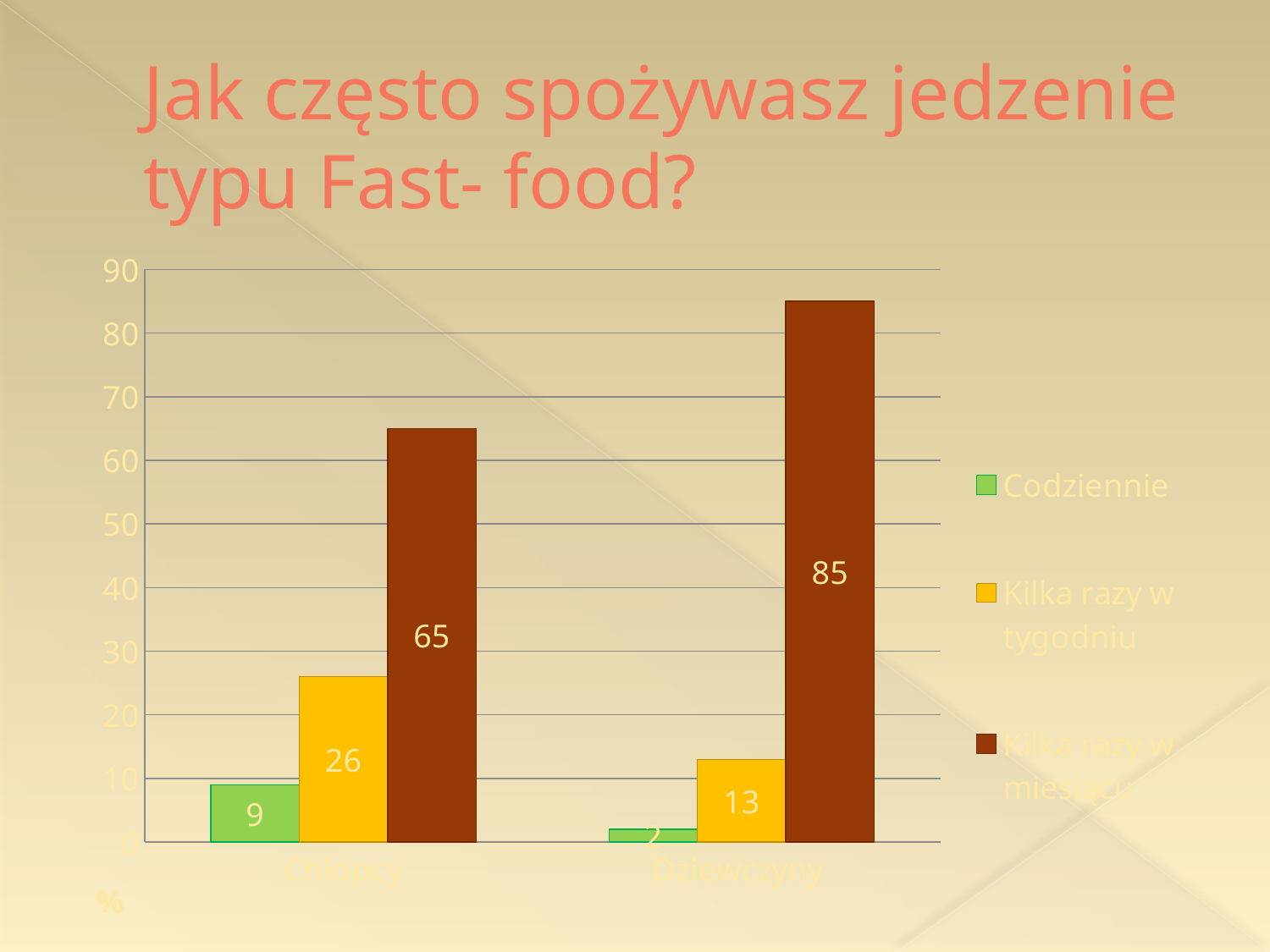
Which series has the highest value for Chłopcy? Kilka razy w miesiącu How many series does the legend list? 3 What is the value for Kilka razy w miesiącu for Dziewczyny? 85 What is the value for Codziennie for Chłopcy? 9 What kind of chart is shown on the slide? bar chart What is the difference between the Kilka razy w miesiącu values for Dziewczyny and Chłopcy? 20 Which is larger: the Kilka razy w tygodniu value for Chłopcy or for Dziewczyny? Chłopcy What is the value for Kilka razy w tygodniu for Dziewczyny? 13 Which series has the lowest value for Dziewczyny? Codziennie What is the value for Kilka razy w tygodniu for Chłopcy? 26 What is the title of the slide? Jak często spożywasz jedzenie typu Fast- food? How many categories are shown on the x axis? 2